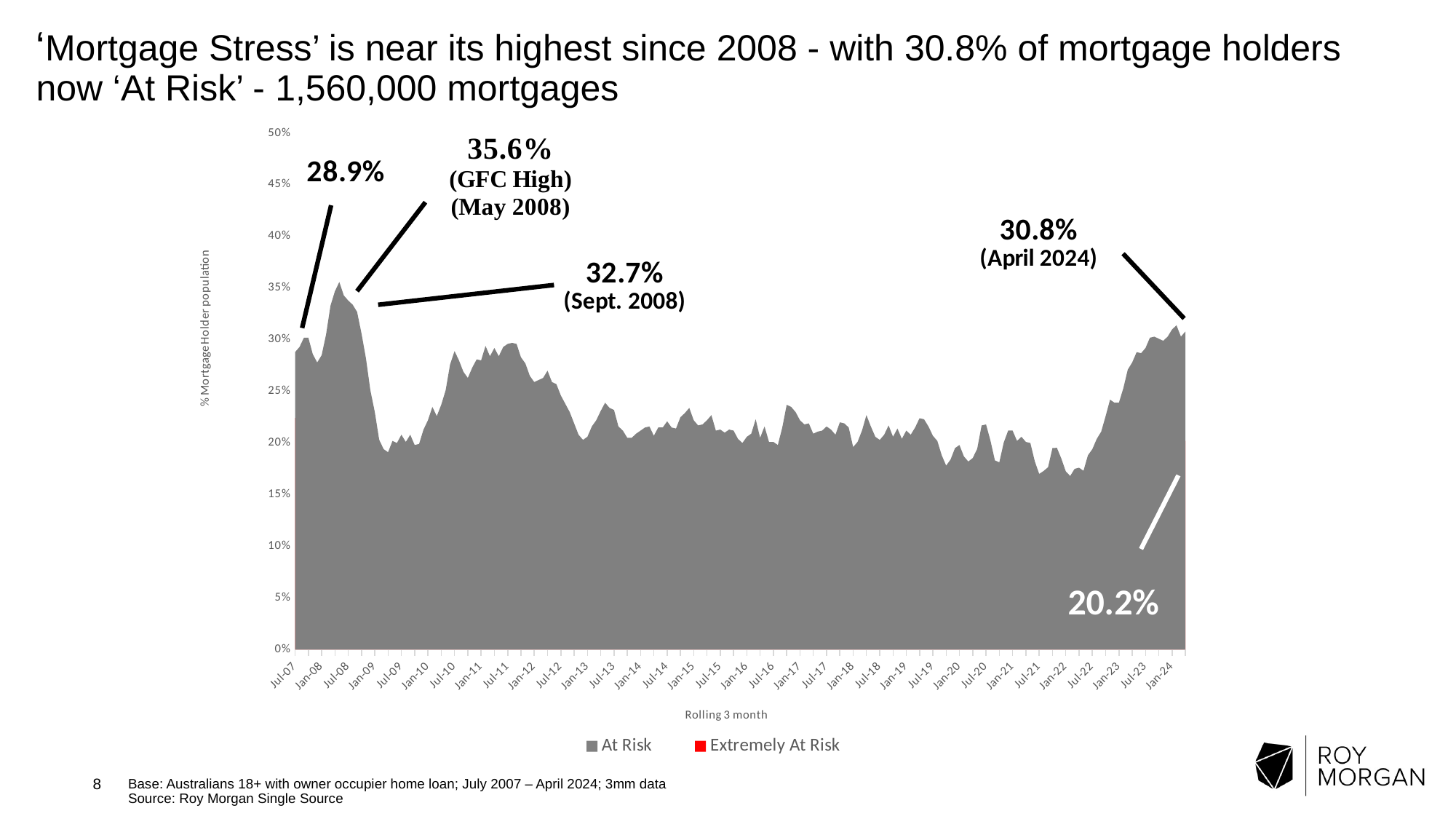
What value is annotated at the start of the series, near Jul-07? 28.9% What value is annotated as the GFC High? 35.6% What kind of chart is shown on the slide? Area chart Is the At Risk value around Jan-22 greater or less than 20%? less Does the At Risk series rise or fall between Jul-22 and Jan-24? Rise What is the label on the x axis of the chart? Rolling 3 month By how many percentage points is the GFC High (May 2008) above the April 2024 value? 4.8 percentage points In which month and year did the GFC High of 35.6% occur? May 2008 Which is larger, the Sept. 2008 value or the April 2024 value? Sept. 2008 What is the annotated value for April 2024? 30.8% What is the annotated value for Sept. 2008? 32.7% How many series does the legend list? 2